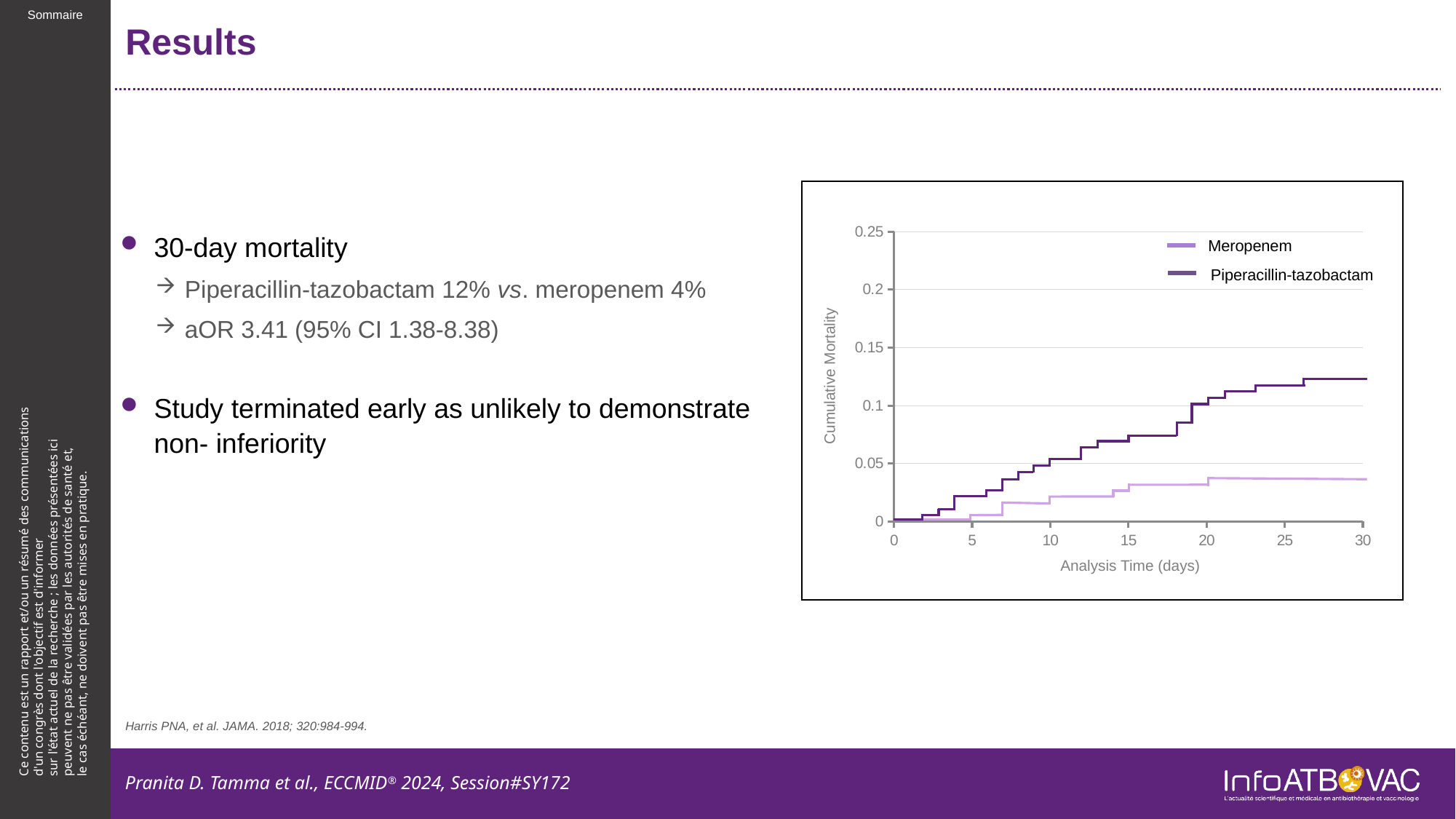
Is the cumulative mortality for Meropenem at 30 days greater or less than 0.05? less Is the cumulative mortality for Meropenem at 20 days greater or less than 0.05? less What is the label of the y axis of the chart? Cumulative Mortality Which two series are listed in the chart legend? Meropenem and Piperacillin-tazobactam Does the cumulative mortality for Piperacillin-tazobactam rise or fall as analysis time increases? rise Is the cumulative mortality for Piperacillin-tazobactam at 30 days greater or less than 0.15? less Which series has the higher cumulative mortality at 30 days, Meropenem or Piperacillin-tazobactam? Piperacillin-tazobactam How many series does the chart legend list? 2 Which series has the lower cumulative mortality at 20 days? Meropenem What kind of chart is shown on the slide? line chart